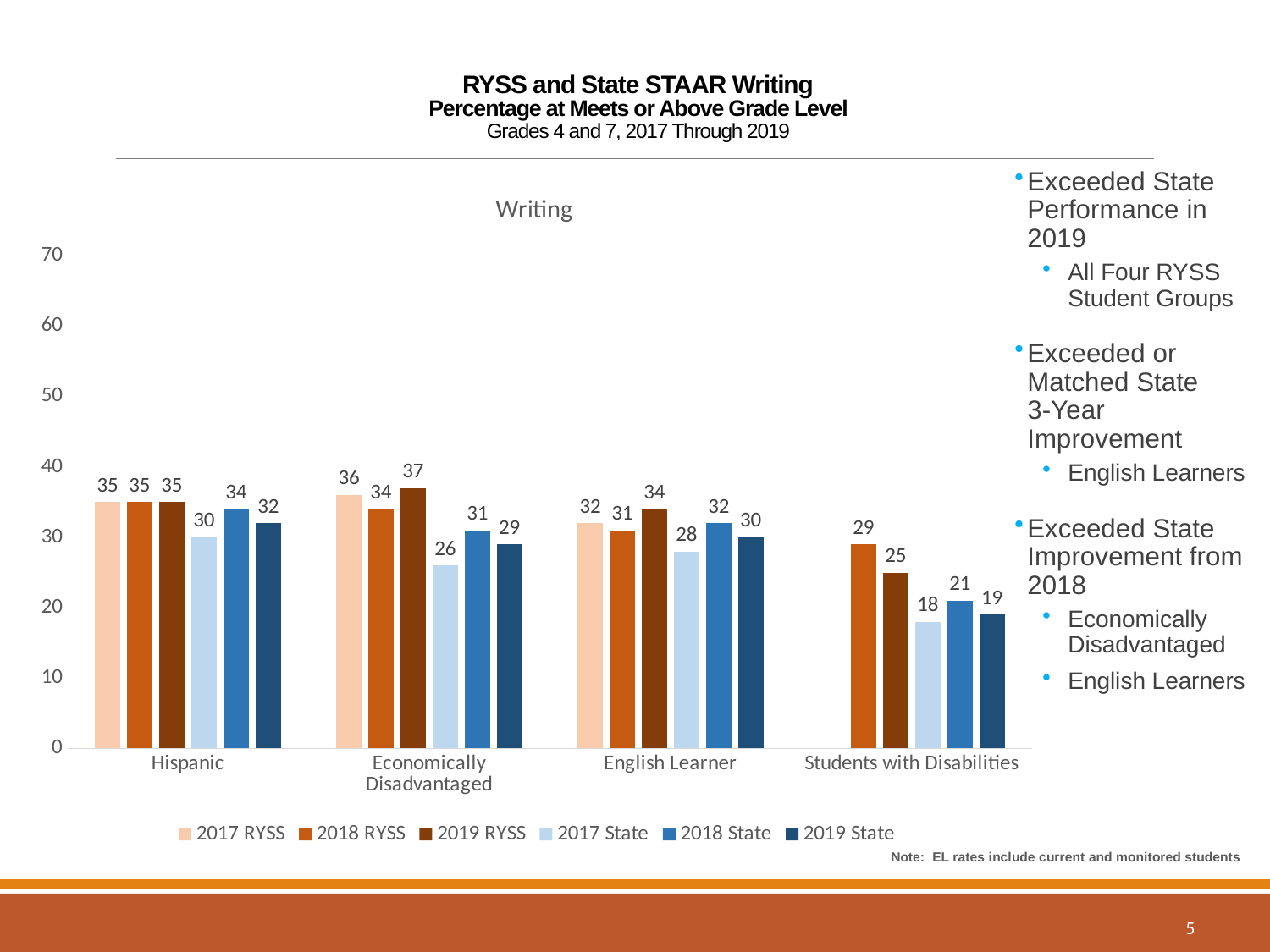
What is the 2017 RYSS value for English Learner? 32 What is the 2019 RYSS value for Economically Disadvantaged? 37 What is the difference between the 2019 RYSS and 2019 State values for Economically Disadvantaged? 8 What is the 2017 State value for Students with Disabilities? 18 What kind of chart is shown on the slide? bar chart Which category has the highest 2019 RYSS value? Economically Disadvantaged For Hispanic, which is larger: the 2018 RYSS value or the 2018 State value? 2018 RYSS Which category has no 2017 RYSS bar? Students with Disabilities How many series does the legend list? 6 How many student group categories are shown on the x axis? 4 Do the RYSS values for Students with Disabilities rise or fall from 2018 to 2019? fall Which category has the lowest 2019 State value? Students with Disabilities